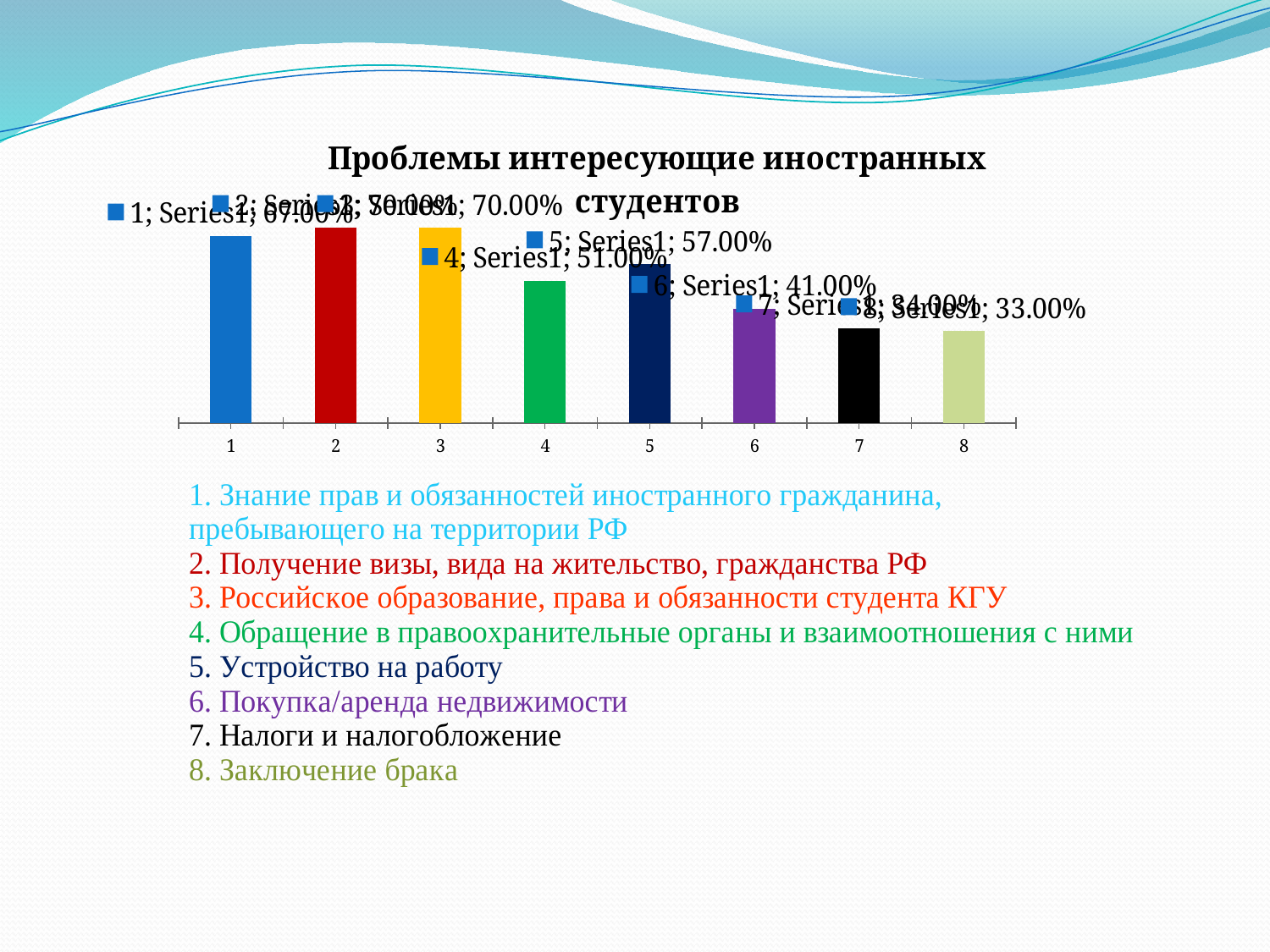
What is the value for category 6? 41.00% How many categories are plotted on the x axis of the chart? 8 Which category has the lowest value? 8 What is the title of the chart? Проблемы интересующие иностранных студентов What is the value for category 5? 57.00% What is the value for category 8? 33.00% What is the difference between the values for category 5 and category 4? 6.00% What is the value for category 1? 67.00% Which is larger, the value for category 4 or category 5? 5 Which category has the highest value? 2 and 3 (tied at 70.00%) What is the value for category 4? 51.00% What type of chart is shown on the slide? bar chart